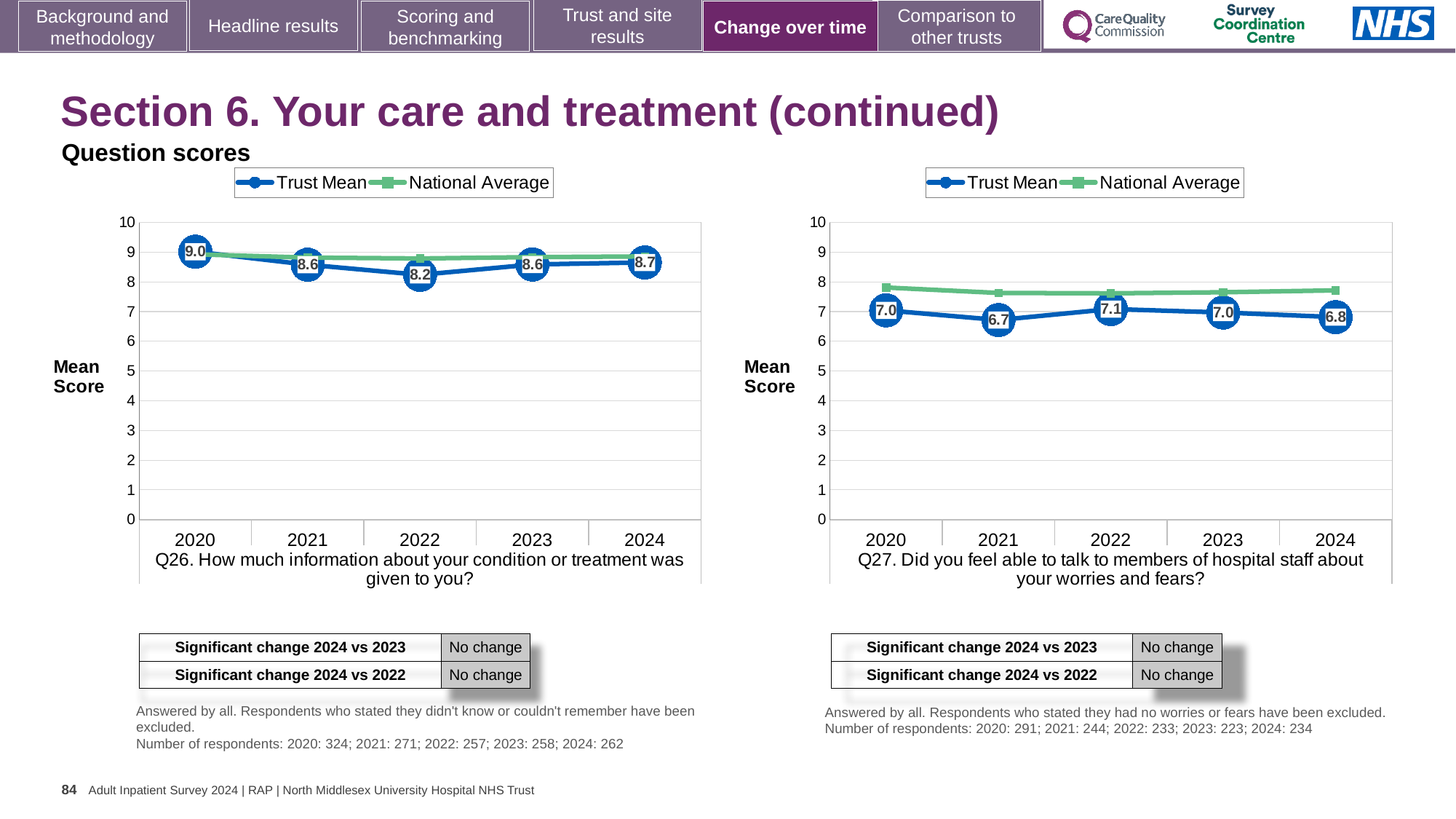
How many series does the legend of the Q27 chart list? 2 In the Q26 chart, what is the Trust Mean score for 2020? 9.0 In the Q27 chart, is the National Average for 2020 greater or less than 7? greater In the Q27 chart, what is the Trust Mean score for 2021? 6.7 In the Q27 chart, which year has the highest Trust Mean score? 2022 How many years are shown on the x axis of the Q26 chart? 5 In the Q26 chart, what is the Trust Mean score for 2022? 8.2 In the Q26 chart, which year has the lowest Trust Mean score? 2022 In the Q26 chart, what is the difference between the Trust Mean scores for 2020 and 2022? 0.8 In the Q26 chart, which year has the highest Trust Mean score? 2020 In the Q27 chart, which is larger in 2023, the Trust Mean or the National Average? National Average In the Q27 chart, what is the Trust Mean score for 2024? 6.8